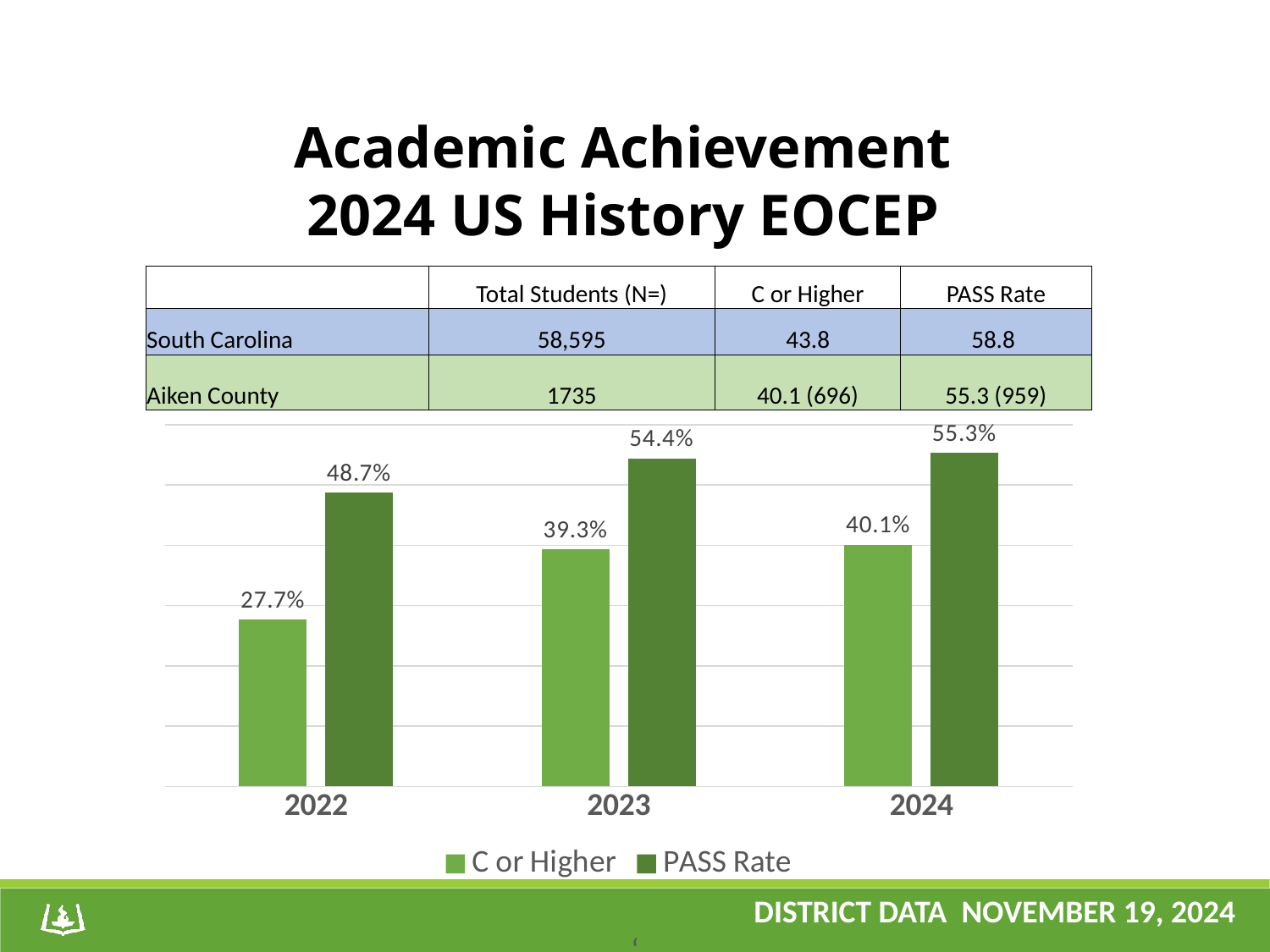
By how much did the C or Higher value increase from 2022 to 2023? 11.6% What is the C or Higher value for 2022 in the chart? 27.7% Which year has the highest PASS Rate in the chart? 2024 How many series does the chart legend list? 2 Which year has the lowest C or Higher value in the chart? 2022 Does the PASS Rate rise or fall from 2022 to 2024? Rise How many years are shown on the x axis of the chart? 3 What is the PASS Rate value for 2023 in the chart? 54.4% What is the difference between the PASS Rate and the C or Higher value for 2022? 21.0% What is the C or Higher value for 2024 in the chart? 40.1% Which is larger: the PASS Rate for 2022 or the C or Higher value for 2024? PASS Rate for 2022 What type of chart is shown on the slide? Bar chart